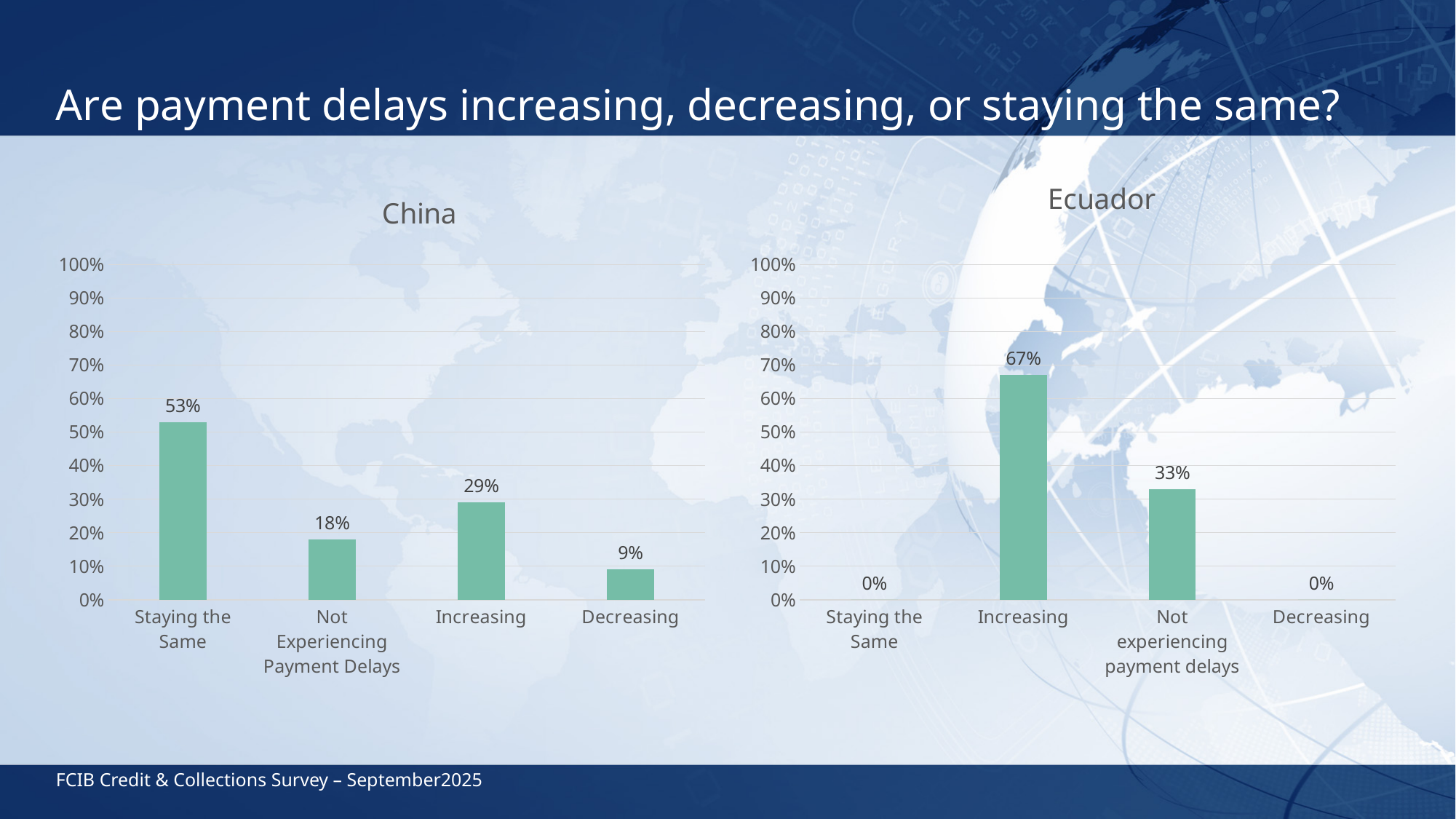
In the Ecuador chart, what is the value for Increasing? 67% In the China chart, which category has the lowest value? Decreasing What kind of chart is the China chart? Bar chart In the China chart, what is the value for Staying the Same? 53% In the Ecuador chart, which category has the highest value? Increasing In the China chart, what is the value for Not Experiencing Payment Delays? 18% In the Ecuador chart, what is the difference between Increasing and Not experiencing payment delays? 34% How many categories does the Ecuador chart show? 4 In the Ecuador chart, what is the value for Not experiencing payment delays? 33% In the China chart, which is larger, Increasing or Decreasing? Increasing In the China chart, what is the difference between Staying the Same and Increasing? 24% In the China chart, which category has the highest value? Staying the Same